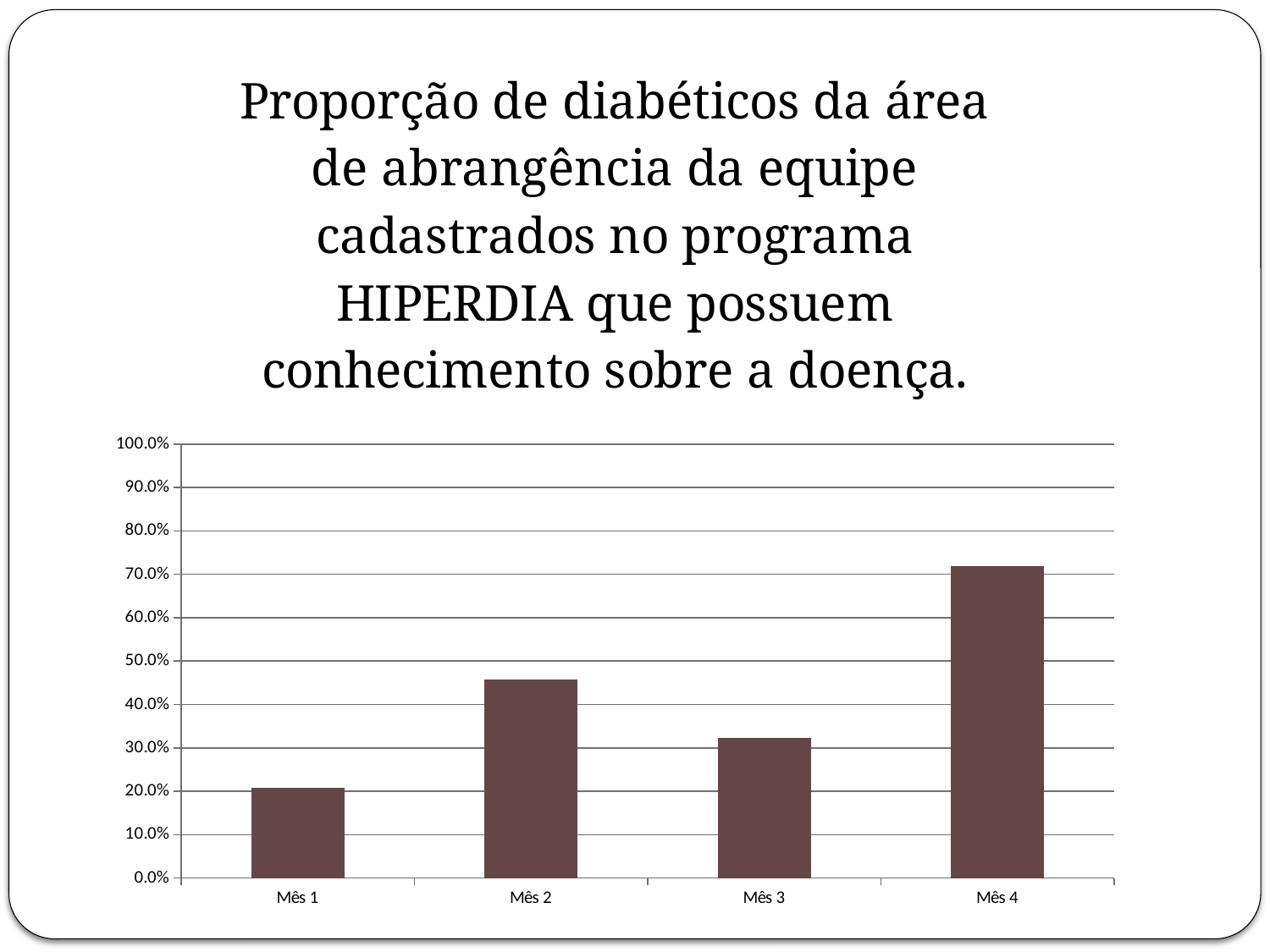
What is the maximum value shown on the y axis? 100.0% Is the value for Mês 1 greater or less than 30.0%? less Which month has the highest value? Mês 4 Is the value for Mês 2 greater or less than 40.0%? greater Does the value fall or rise from Mês 2 to Mês 3? fall Which is larger, the value for Mês 2 or the value for Mês 3? Mês 2 Which is larger, the value for Mês 1 or the value for Mês 4? Mês 4 How many categories (months) are plotted on the x axis? 4 What kind of chart is shown on the slide? bar chart Is the value for Mês 4 greater or less than 60.0%? greater Which month has the lowest value? Mês 1